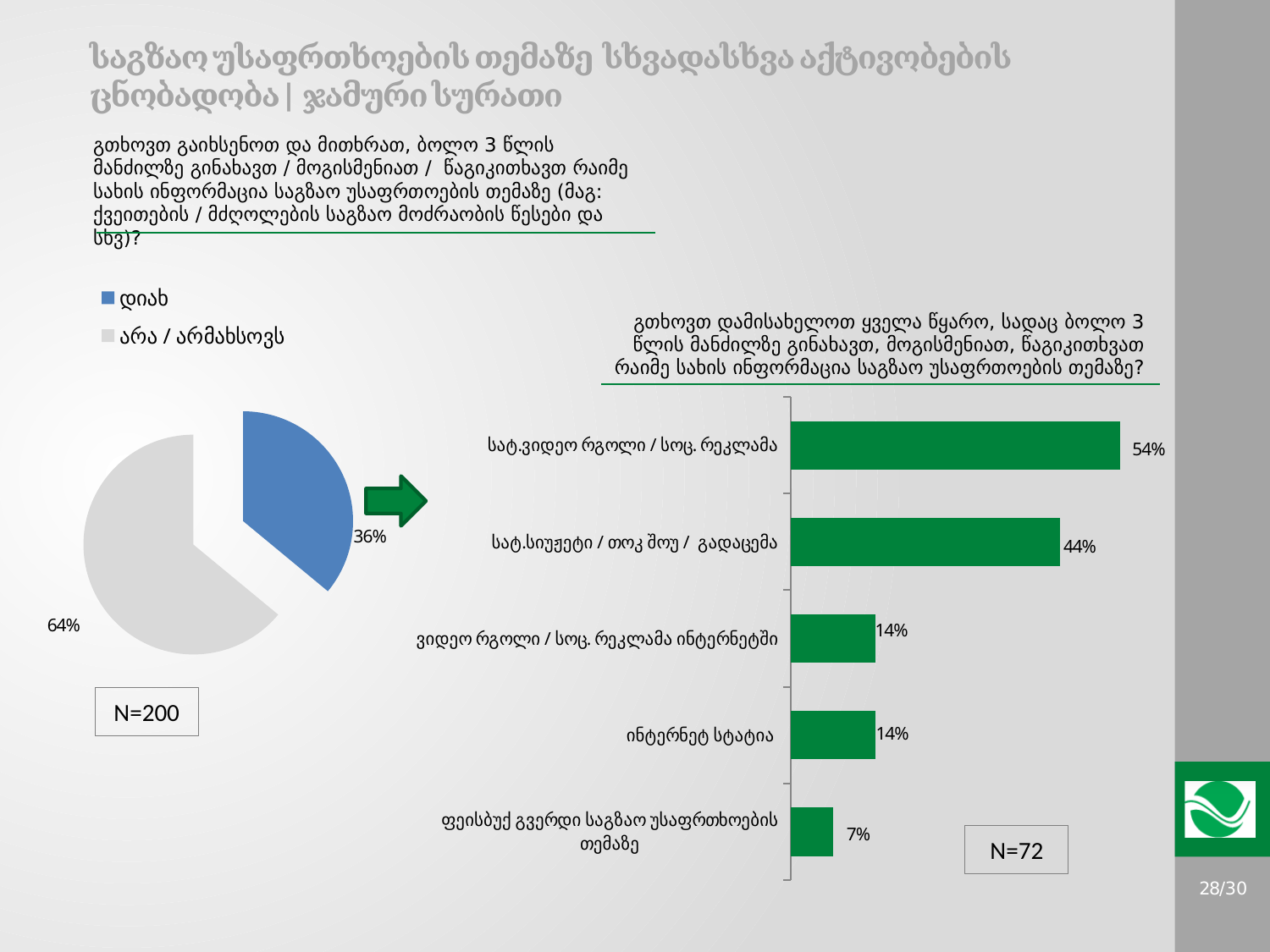
In the bar chart on the right, which category has the lowest value? ფეისბუქ გვერდი საგზაო უსაფრთხოების თემაზე In the bar chart on the right, what is the value for "სატ.ვიდეო რგოლი / სოც. რეკლამა"? 54% In the bar chart on the right, what is the value for "ინტერნეტ სტატია"? 14% In the pie chart on the left, what share is labelled "დიახ"? 36% In the bar chart on the right, how many categories are shown? 5 In the bar chart on the right, what is the value for "სატ.სიუჟეტი / თოქ შოუ / გადაცემა"? 44% In the bar chart on the right, which category has the highest value? სატ.ვიდეო რგოლი / სოც. რეკლამა In the pie chart on the left, how many slices are there? 2 What type of chart is shown on the right side of the slide? Bar chart In the pie chart on the left, what share is labelled "არა / არმახსოვს"? 64% In the pie chart on the left, which slice is larger, "დიახ" or "არა / არმახსოვს"? არა / არმახსოვს In the bar chart on the right, what is the difference between "სატ.ვიდეო რგოლი / სოც. რეკლამა" and "სატ.სიუჟეტი / თოქ შოუ / გადაცემა"? 10%